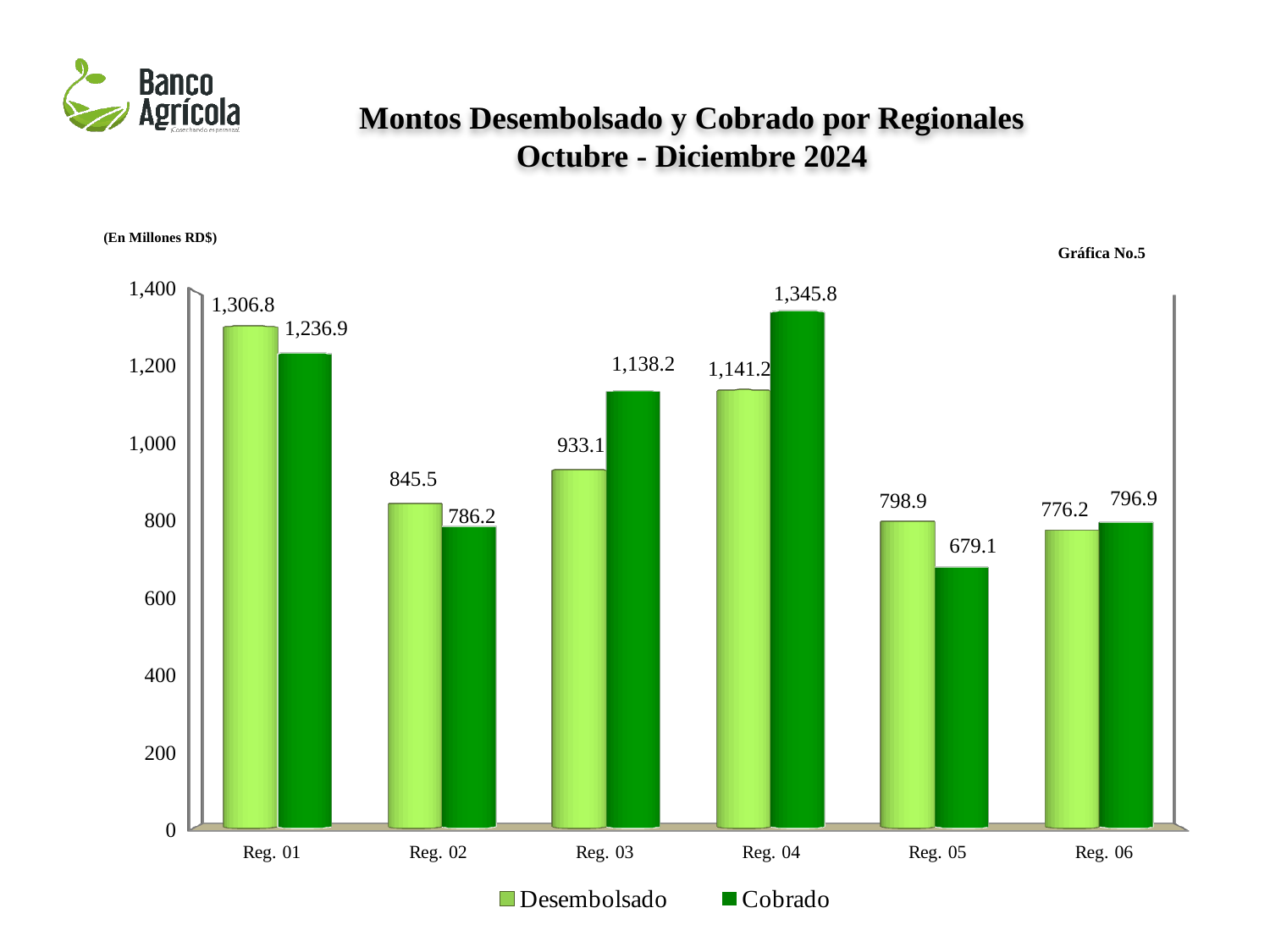
Which region has the highest Desembolsado value? Reg. 01 What kind of chart is shown on the slide? Bar chart What is the Cobrado value for Reg. 01? 1,236.9 Which region has the lowest Desembolsado value? Reg. 06 What is the Cobrado value for Reg. 05? 679.1 How many series does the legend list? 2 How many regions are shown on the x axis? 6 Which region has the highest Cobrado value? Reg. 04 What is the Desembolsado value for Reg. 03? 933.1 Is the Cobrado value for Reg. 03 greater or less than 1,000? greater What is the difference between the Desembolsado and Cobrado values for Reg. 04? 204.6 For Reg. 02, which is larger, Desembolsado or Cobrado? Desembolsado